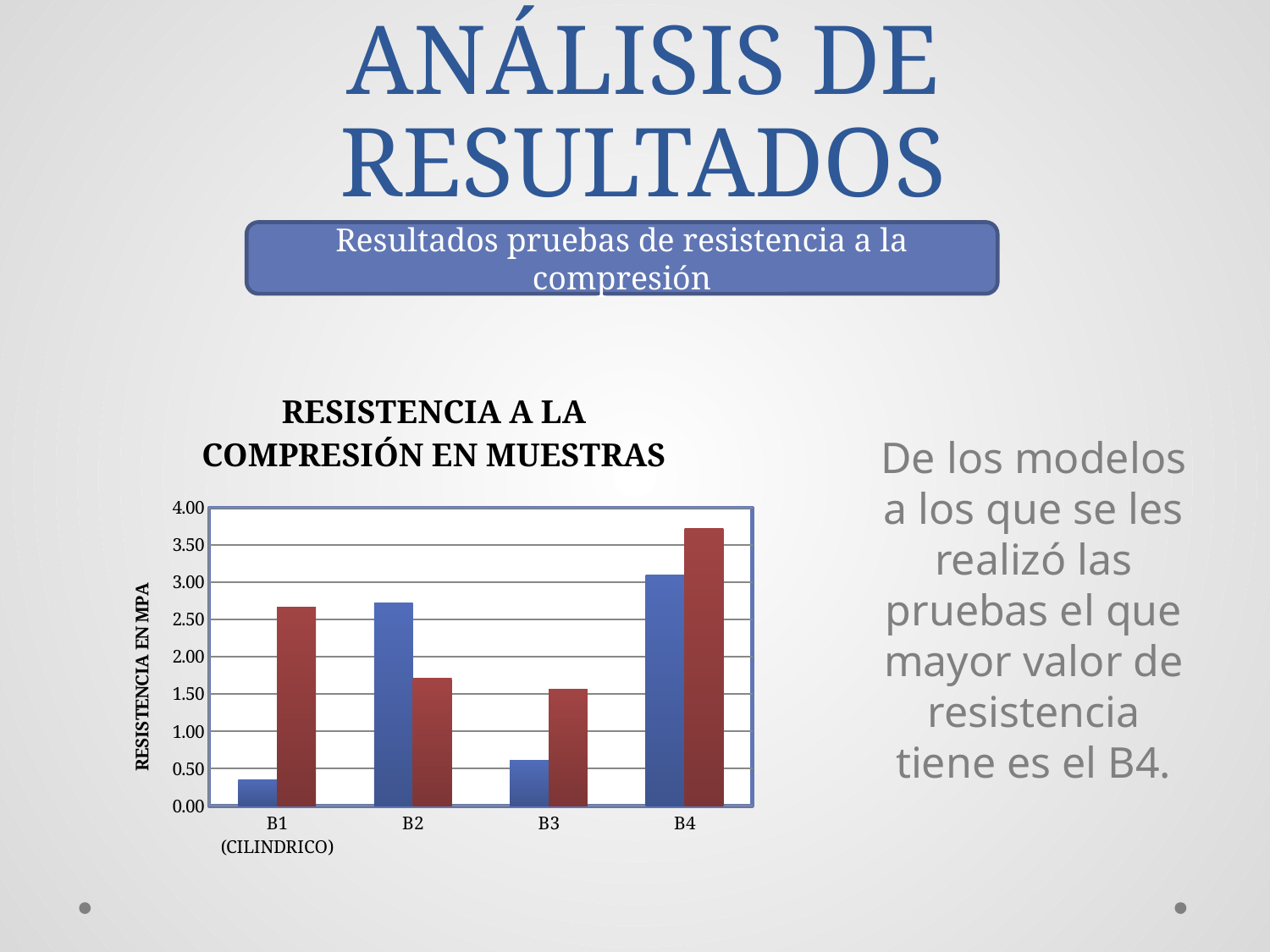
Which category has the tallest blue bar? B4 What is the label of the vertical axis of the chart? RESISTENCIA EN MPA Which category has the shortest red bar? B3 How many categories are shown on the x axis of the chart? 4 For B2, which bar is taller, the blue bar or the red bar? the blue bar Is the value of the red bar for B4 greater or less than 3.50? greater What kind of chart is shown on the slide? bar chart Which category has the tallest red bar? B4 Which category has the shortest blue bar? B1 (CILINDRICO) Is the value of the blue bar for B2 greater or less than 2.50? greater What is the title of the chart? RESISTENCIA A LA COMPRESIÓN EN MUESTRAS Is the value of the blue bar for B1 (CILINDRICO) greater or less than 0.50? less